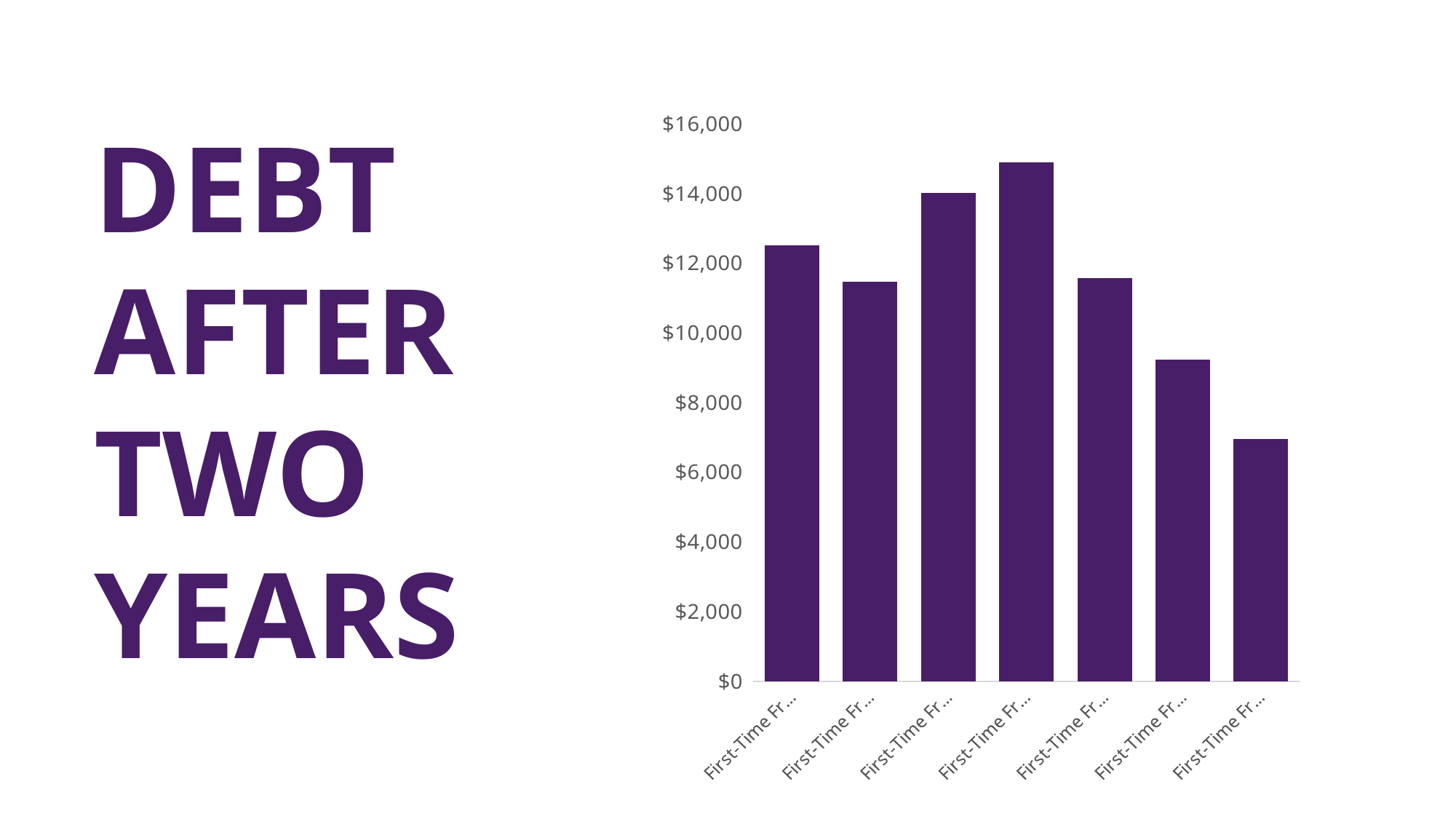
Which bar is the tallest in the chart? the fourth bar Which is larger, the third bar or the sixth bar? the third bar Which is larger, the first bar or the second bar? the first bar Is the value of the first bar greater or less than $12,000? greater Which bar is the shortest in the chart? the seventh (last) bar Is the value of the seventh bar greater or less than $8,000? less How many bars are plotted in the chart? 7 Is the value of the fourth bar greater or less than $14,000? greater What is the highest value shown on the vertical axis? $16,000 What is the title text shown on the slide? DEBT AFTER TWO YEARS What kind of chart is shown on the slide? bar chart